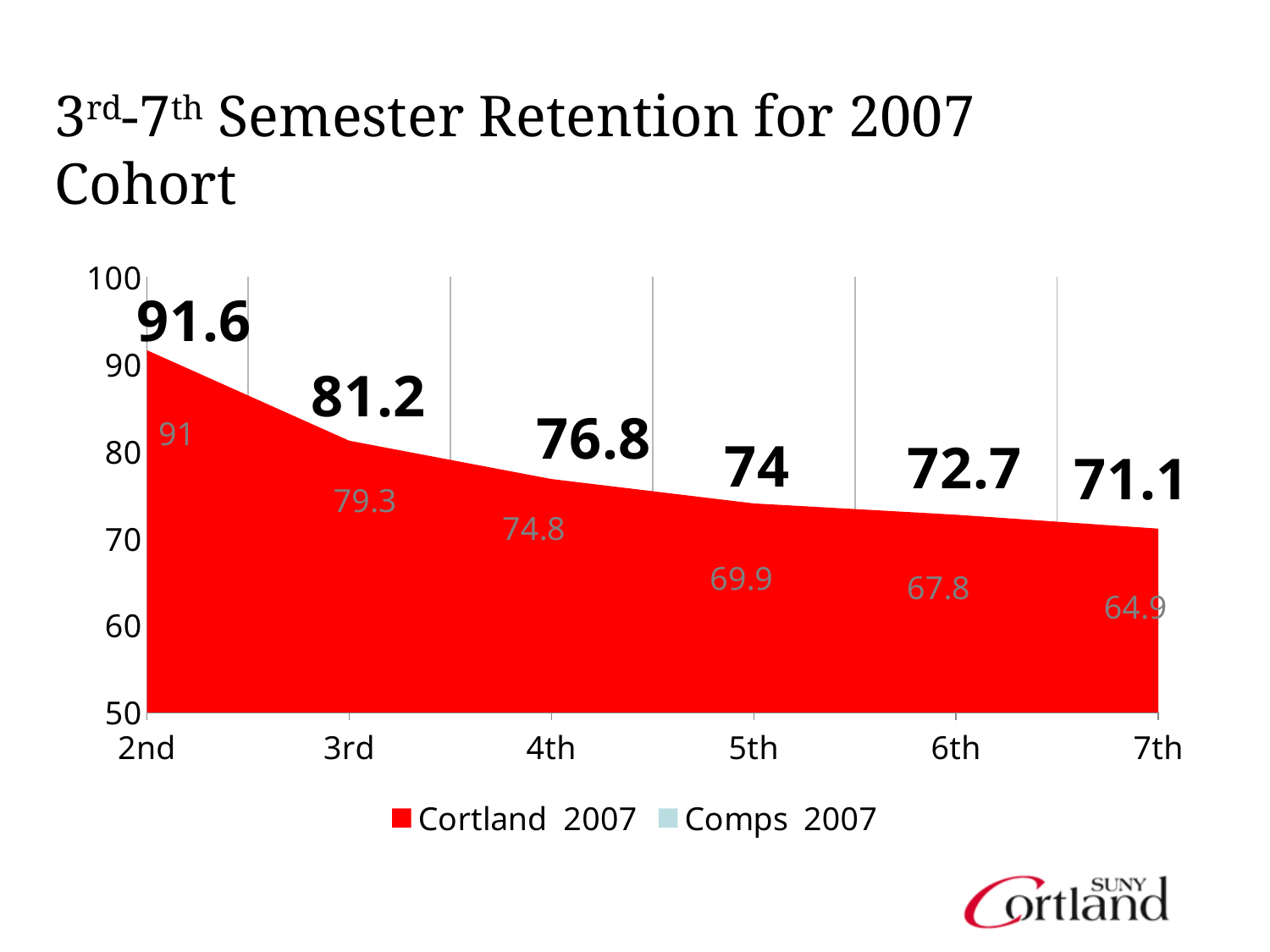
What is the Comps 2007 value at the 5th semester? 69.9 At which semester is the Cortland 2007 value lowest? 7th Which is larger at the 4th semester, Cortland 2007 or Comps 2007? Cortland 2007 What is the Cortland 2007 retention value at the 2nd semester? 91.6 Do the Cortland 2007 values rise or fall from the 2nd to the 7th semester? fall How many series does the legend list? 2 What is the Comps 2007 value at the 3rd semester? 79.3 What is the difference between the Cortland 2007 values at the 2nd and 3rd semesters? 10.4 What is the Cortland 2007 value at the 7th semester? 71.1 How many semesters are shown on the x axis? 6 At which semester is the Comps 2007 value highest? 2nd What is the difference between the Cortland 2007 and Comps 2007 values at the 7th semester? 6.2